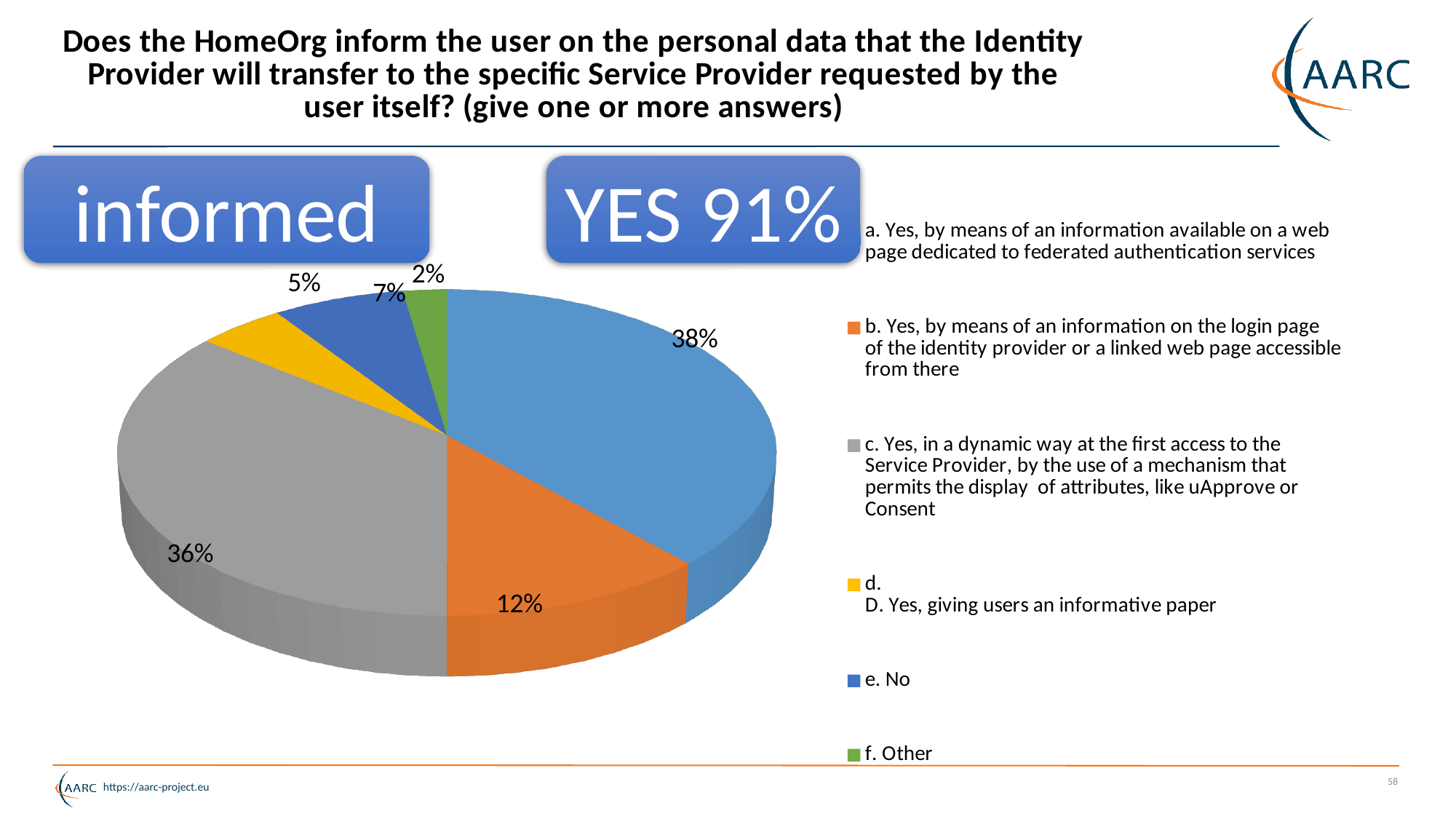
What percentage is shown for option e, 'No'? 7% What percentage is shown for option f, 'Other'? 2% What percentage is shown for option d, 'Yes, giving users an informative paper'? 5% Which option has the smallest share of the pie? f. Other What kind of chart is shown on the slide? pie chart What percentage is shown for option a, 'Yes, by means of an information available on a web page dedicated to federated authentication services'? 38% Which option has the largest share of the pie? a. Yes, by means of an information available on a web page dedicated to federated authentication services Which colour represents option e, 'No', in the pie chart? blue How many slices does the pie chart have? 6 What is the difference in percentage points between option a (38%) and option c (36%)? 2 What percentage is shown for option c, 'Yes, in a dynamic way at the first access to the Service Provider'? 36% What percentage is shown for option b, 'Yes, by means of an information on the login page of the identity provider or a linked web page accessible from there'? 12%